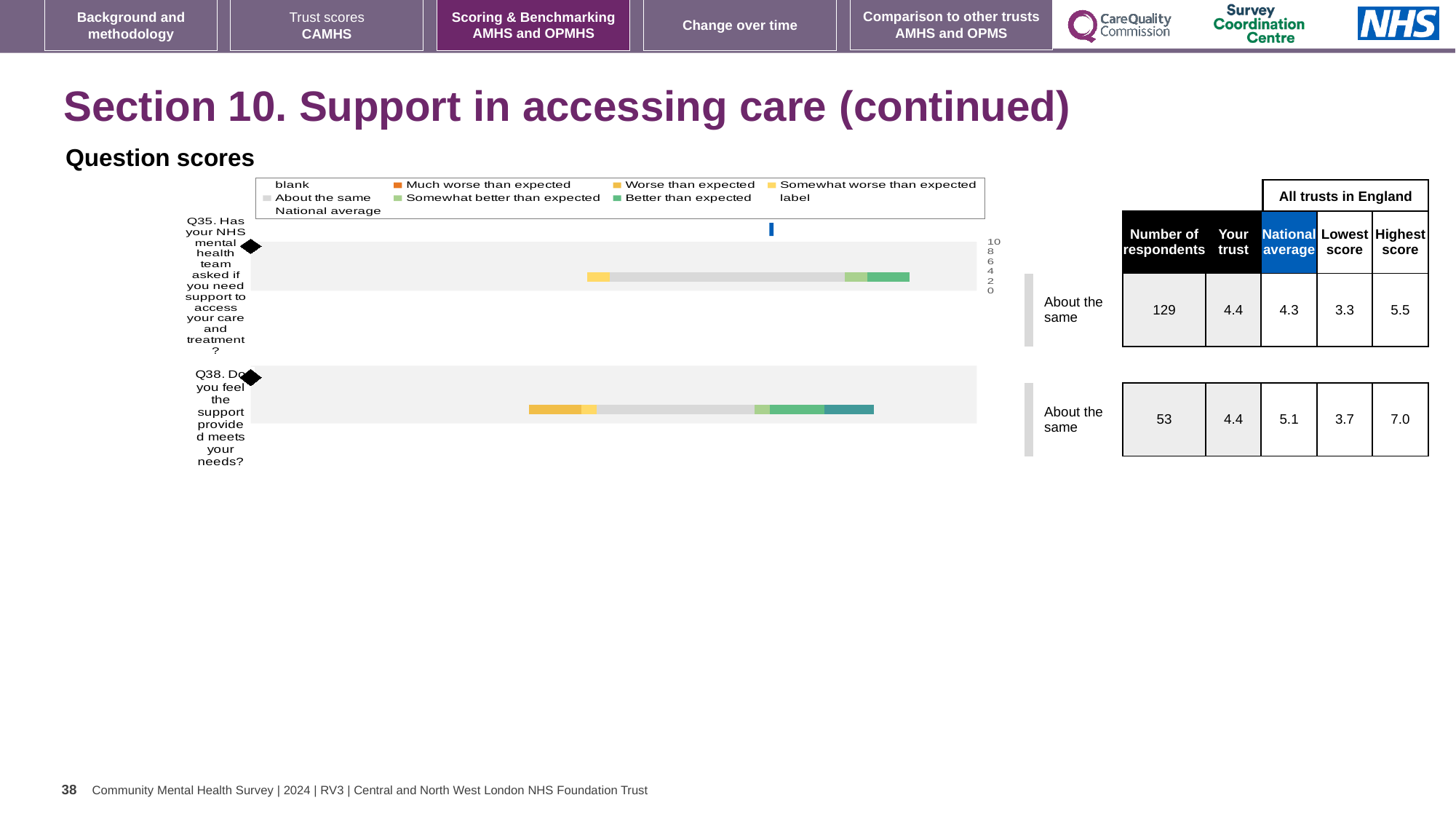
Which question had more respondents, Q35 or Q38? Q35 What kind of chart is used to show the question scores on this slide? Bar chart Which question has the higher national average, Q35 or Q38? Q38 What is the difference between the highest score and the lowest score for Q38? 3.3 What is the national average score for Q38 (Do you feel the support provided meets your needs?)? 5.1 What is the highest score among all trusts in England for Q35? 5.5 How many respondents answered Q35? 129 What is the 'Your trust' score for Q35 (Has your NHS mental health team asked if you need support to access your care and treatment?)? 4.4 How many entries does the legend of the question scores chart list? 9 What colour does the legend use for 'Much worse than expected'? Orange How many questions are plotted as bars in the question scores chart? 2 What benchmark category is shown for Q38 next to the chart? About the same